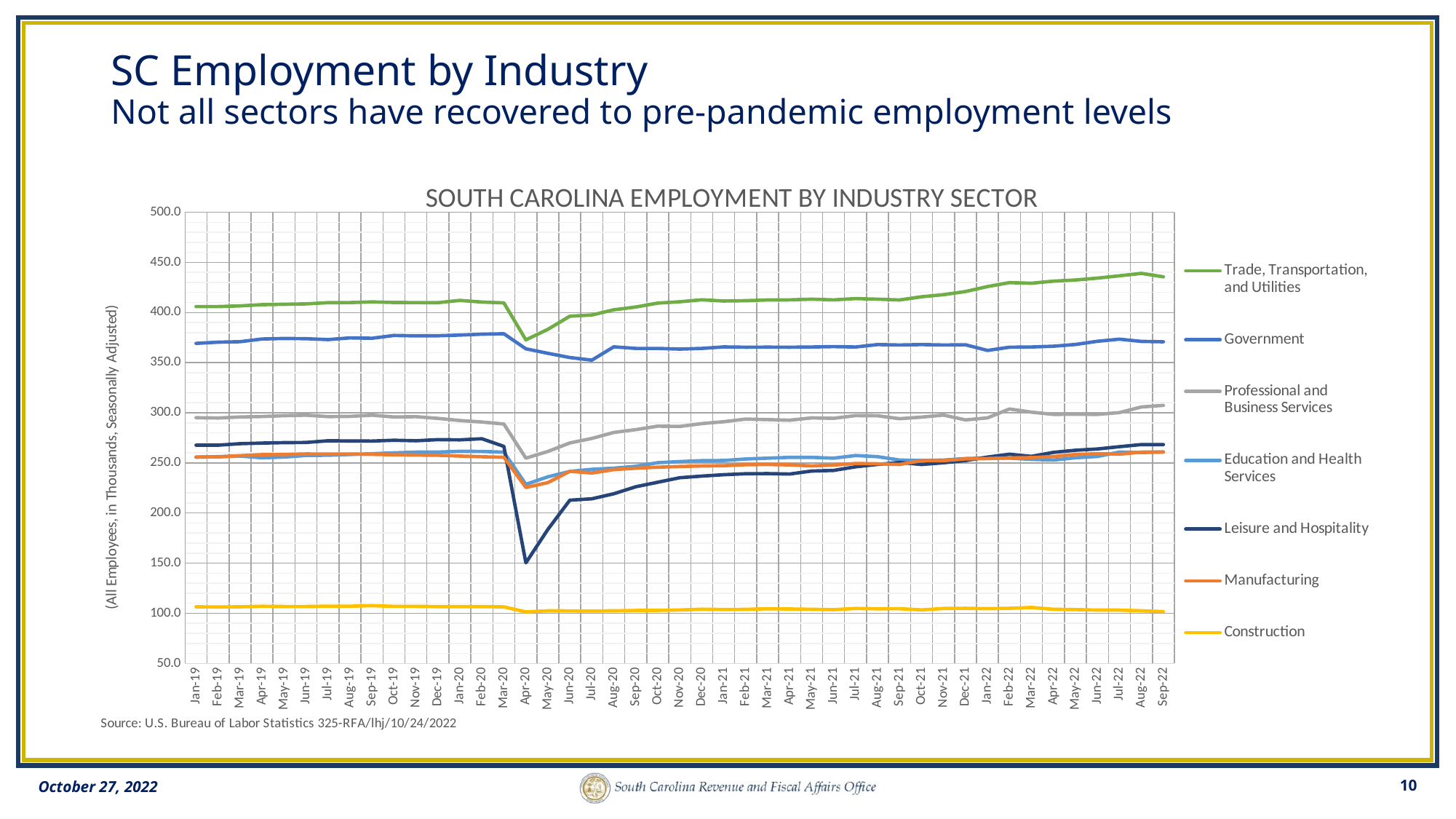
What kind of chart is shown on the slide? line chart Is the value for Government in Jan-19 greater or less than 350? greater Is the value for Construction in Jan-19 greater or less than 150? less Which series shows the sharpest drop in Apr-20? Leisure and Hospitality In Jan-19, which is larger: Government or Professional and Business Services? Government Is the value for Leisure and Hospitality in Apr-20 greater or less than 200? less Which industry sector has the highest employment across the whole period? Trade, Transportation, and Utilities How many series does the legend list? 7 Which industry sector has the lowest employment across the whole period? Construction Does the Trade, Transportation, and Utilities line rise or fall from Jan-21 to Sep-22? rise What is the title of the chart? SOUTH CAROLINA EMPLOYMENT BY INDUSTRY SECTOR